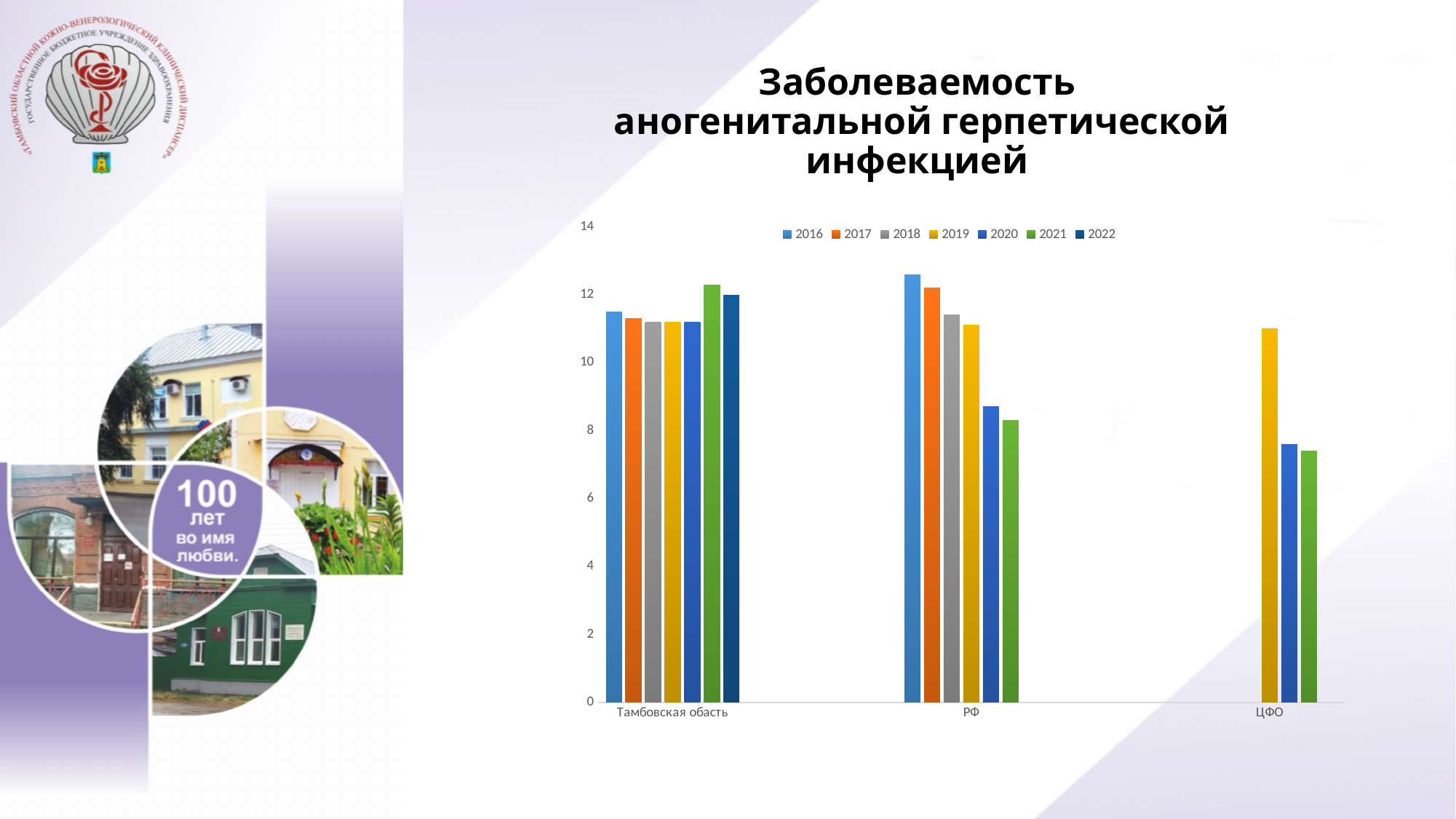
Is the value for 2021 in the Тамбовская область group greater or less than 12? greater Is the value for 2016 in the РФ group greater or less than 12? greater How many categories are shown on the x axis? 3 What kind of chart is shown on the slide? bar chart Which is larger: the 2020 value for Тамбовская область or the 2020 value for ЦФО? Тамбовская область How many series does the legend list? 7 Do the values in the РФ group rise or fall from 2016 to 2021? fall Is the value for 2021 in the ЦФО group greater or less than 8? less What is the title of the chart? Заболеваемость аногенитальной герпетической инфекцией Which year has the lowest value in the ЦФО group? 2021 Which year has the highest value in the РФ group? 2016